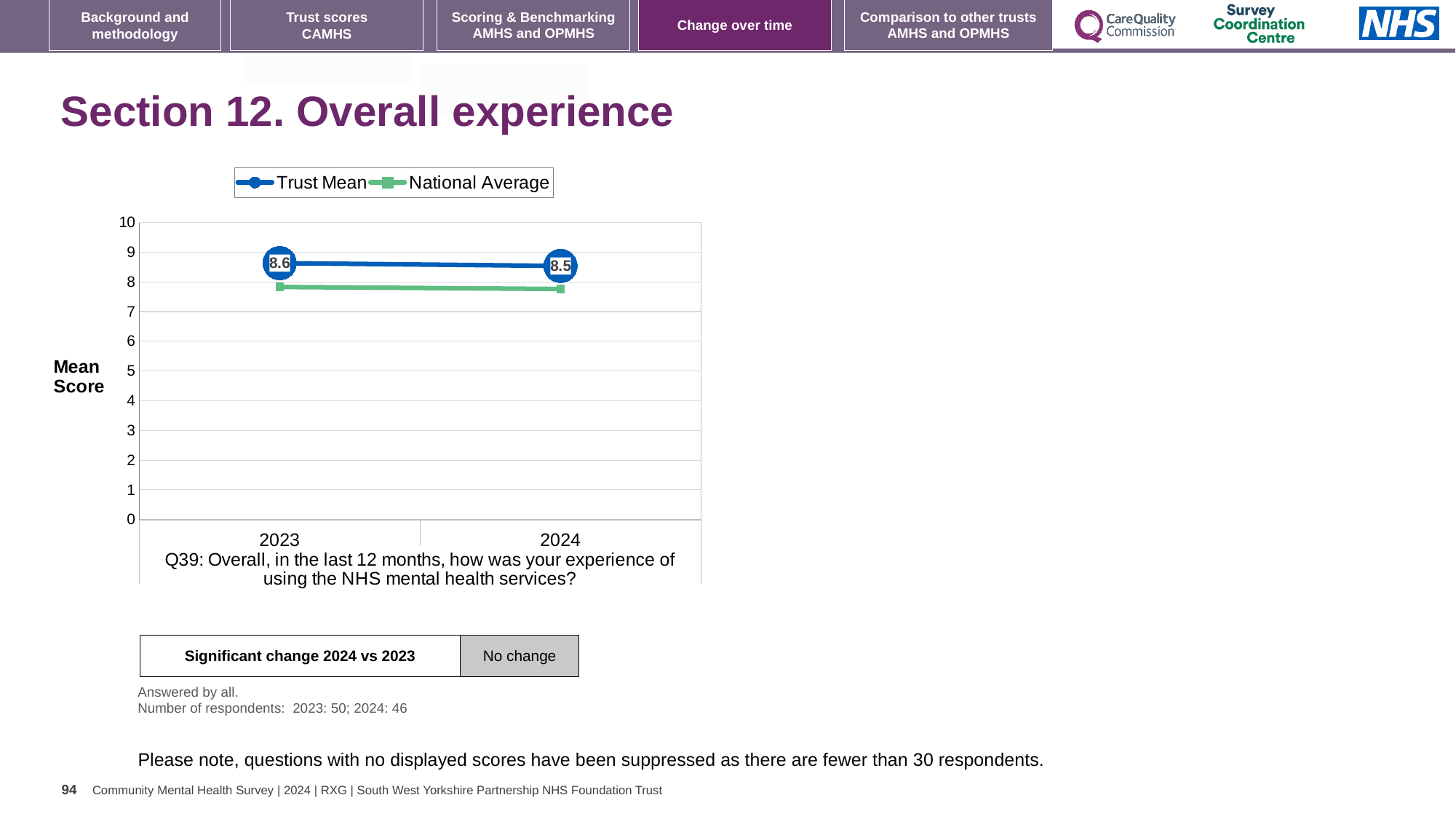
What is the label on the y axis of the chart? Mean Score How many years are plotted on the x axis of the chart? 2 In which year was the Trust Mean higher, 2023 or 2024? 2023 Is the National Average value for 2023 greater or less than 8? less What is the Trust Mean score for 2024? 8.5 In 2023, which is higher: the Trust Mean or the National Average? Trust Mean By how much did the Trust Mean change from 2023 to 2024? 0.1 Does the Trust Mean rise or fall from 2023 to 2024? Fall Is the National Average value for 2024 greater or less than 7? greater What kind of chart is shown on the slide? Line chart What is the Trust Mean score for 2023? 8.6 How many series does the chart legend list? 2